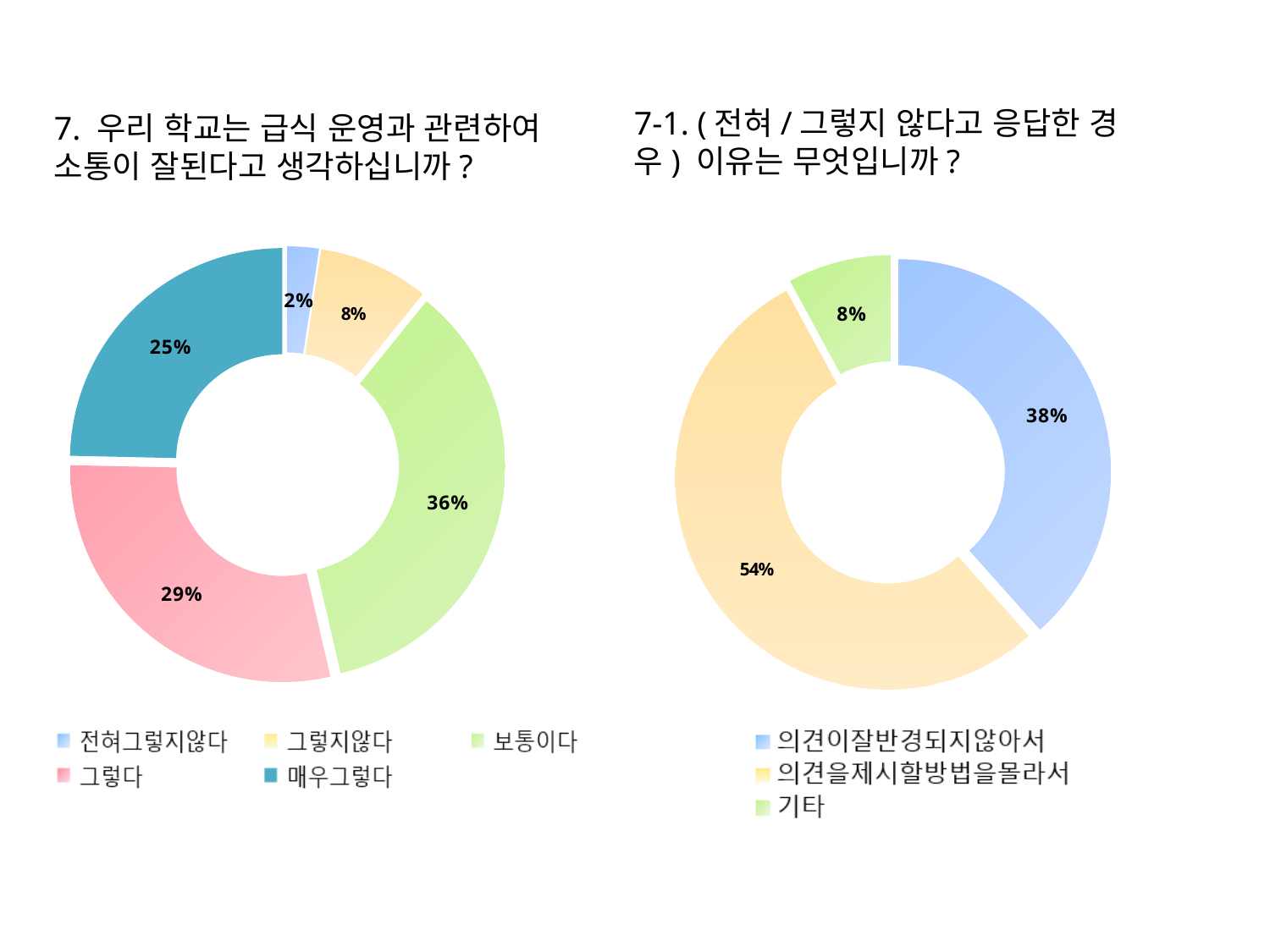
In the left chart (question 7), what share of respondents answered 보통이다? 36% In the left chart (question 7), which response has the largest share? 보통이다 In the left chart (question 7), what share of respondents answered 매우그렇다? 25% In the right chart (question 7-1), which reason has the largest share? 의견을제시할방법을몰라서 In the left chart (question 7), which is larger: 그렇다 or 매우그렇다? 그렇다 In the left chart (question 7), which response has the smallest share? 전혀그렇지않다 What type of chart is used for question 7-1 on the right? Doughnut (pie) chart In the right chart (question 7-1), what share of respondents chose 기타? 8% In the right chart (question 7-1), what share of respondents chose 의견을제시할방법을몰라서? 54% How many categories does the left chart (question 7) show? 5 In the right chart (question 7-1), what is the difference in percentage points between 의견을제시할방법을몰라서 and 의견이잘반경되지않아서? 16 In the left chart (question 7), what is the difference in percentage points between 그렇다 and 그렇지않다? 21